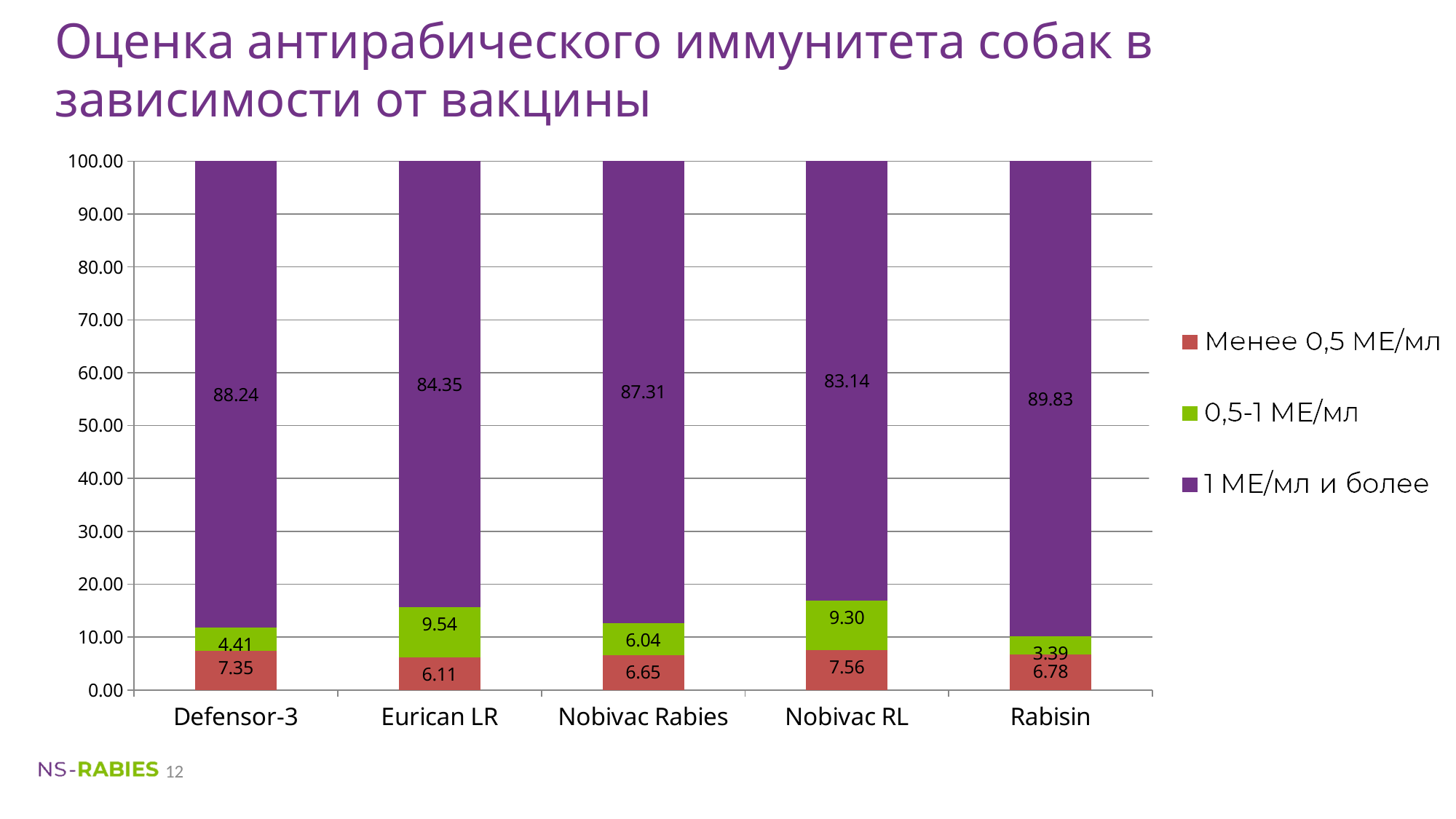
Which vaccine has the highest value for 'Менее 0,5 МЕ/мл'? Nobivac RL Which vaccine has the highest value for '1 МЕ/мл и более'? Rabisin What is the difference between the '0,5-1 МЕ/мл' values for Eurican LR and Rabisin? 6.15 What type of chart is shown on the slide? Stacked bar chart How many series does the legend list? 3 What is the value of the 'Менее 0,5 МЕ/мл' segment for Nobivac Rabies? 6.65 Which vaccine has the lowest value for '0,5-1 МЕ/мл'? Rabisin What is the value of the '1 МЕ/мл и более' segment for Eurican LR? 84.35 Which is larger: the '1 МЕ/мл и более' value for Nobivac Rabies or for Nobivac RL? Nobivac Rabies What is the value of the '0,5-1 МЕ/мл' segment for Nobivac RL? 9.30 How many vaccines (categories) are shown on the x axis? 5 What is the total of the stacked bar for Defensor-3? 100.00